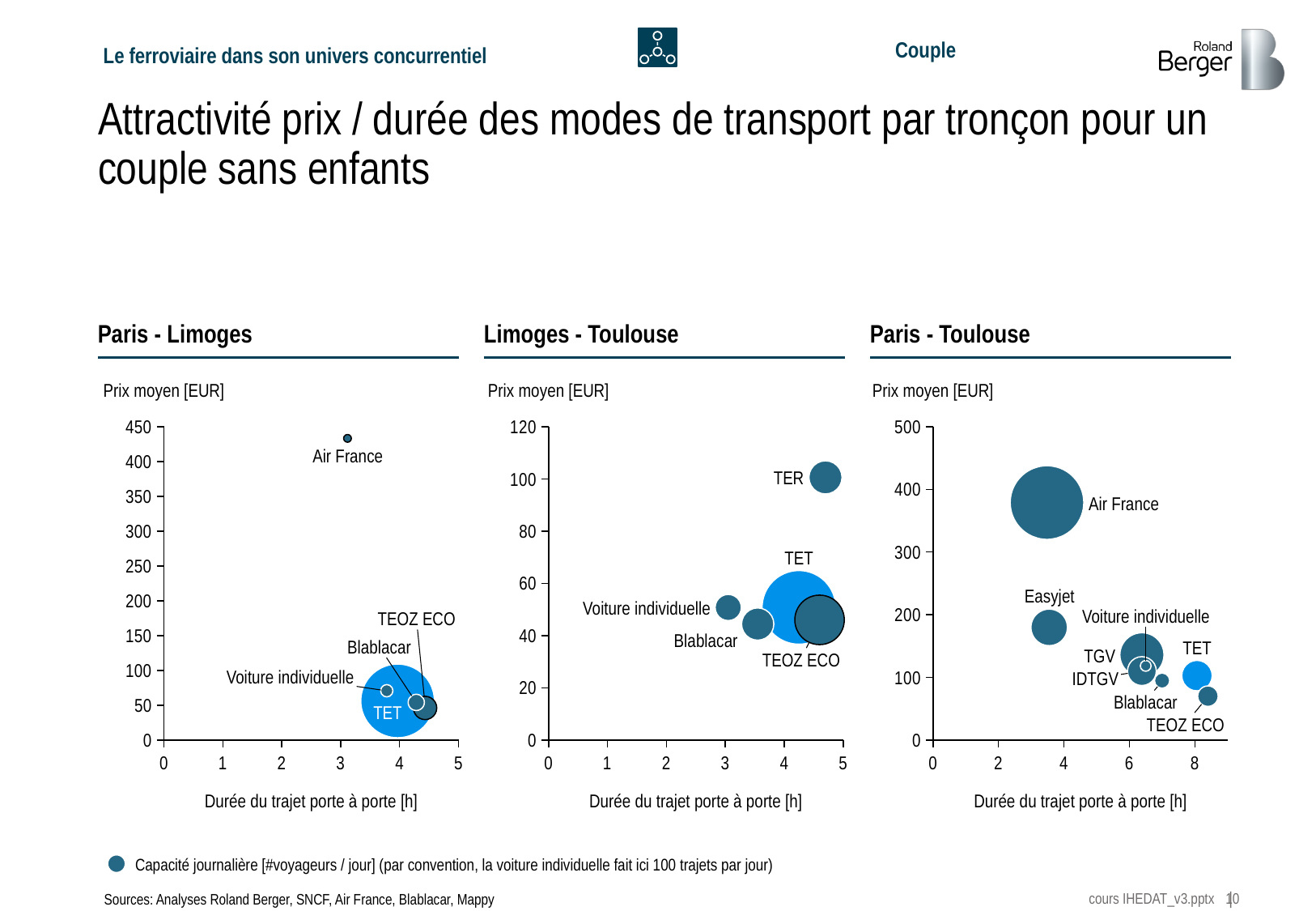
In the Limoges - Toulouse chart, is the door-to-door duration for Voiture individuelle greater or less than 4 hours? less In the Paris - Toulouse chart, is the average price for Air France greater or less than 300? greater In the Paris - Toulouse chart, which transport mode has the highest average price? Air France In the Limoges - Toulouse chart, which transport mode has the highest average price? TER In the Paris - Limoges chart, which transport mode has the highest average price? Air France What is the x-axis label of the Paris - Toulouse chart? Durée du trajet porte à porte [h] In the Paris - Toulouse chart, which has the higher average price, Air France or Easyjet? Air France What kind of chart is used for the Paris - Limoges section? Bubble chart In the Limoges - Toulouse chart, is the average price for TER greater or less than 80? greater How many transport modes are plotted in the Paris - Limoges chart? 5 How many transport modes are plotted in the Paris - Toulouse chart? 8